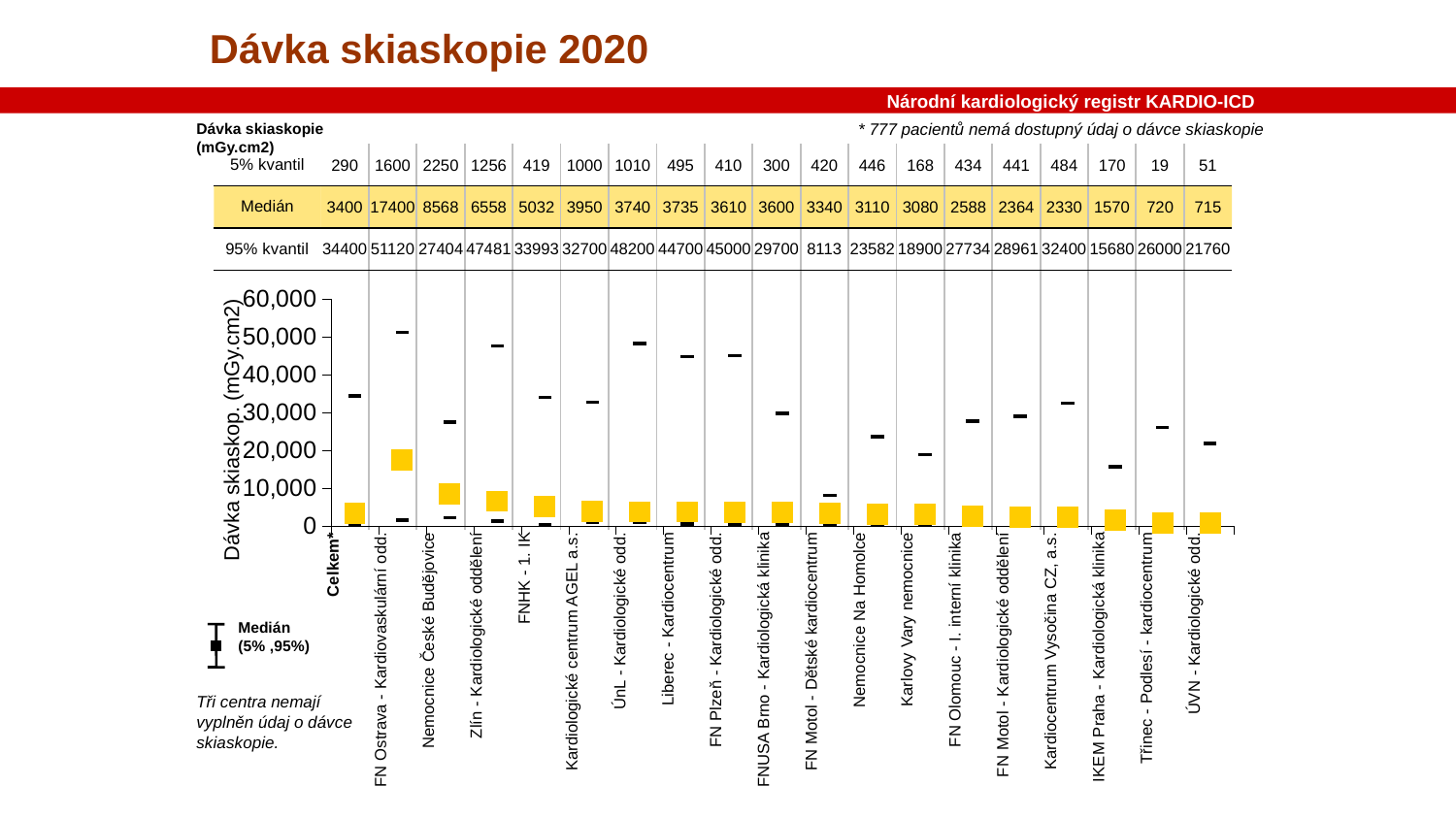
How many categories (centres, including Celkem*) are shown on the x axis of the chart? 19 Which centre has the lowest 95% kvantil value? FN Motol - Dětské kardiocentrum According to the note on the slide, how many patients have no available skiaskopie dose data? 777 Which centre has the highest 95% kvantil value? FN Ostrava - Kardiovaskulární odd. What is the difference between the median for FN Ostrava - Kardiovaskulární odd. and the median for Celkem*? 14000 Which centre has the highest median (Medián) value? FN Ostrava - Kardiovaskulární odd. What is the label of the y axis of the chart? Dávka skiaskop. (mGy.cm2) What is the 5% kvantil value for Celkem*? 290 What is the median (Medián) value for FN Ostrava - Kardiovaskulární odd.? 17400 Is the 95% kvantil value for FN Ostrava - Kardiovaskulární odd. greater or less than 50,000? greater Which has the larger 95% kvantil value: Zlín - Kardiologické oddělení or FNHK - 1. IK? Zlín - Kardiologické oddělení What is the 95% kvantil value for Zlín - Kardiologické oddělení? 47481